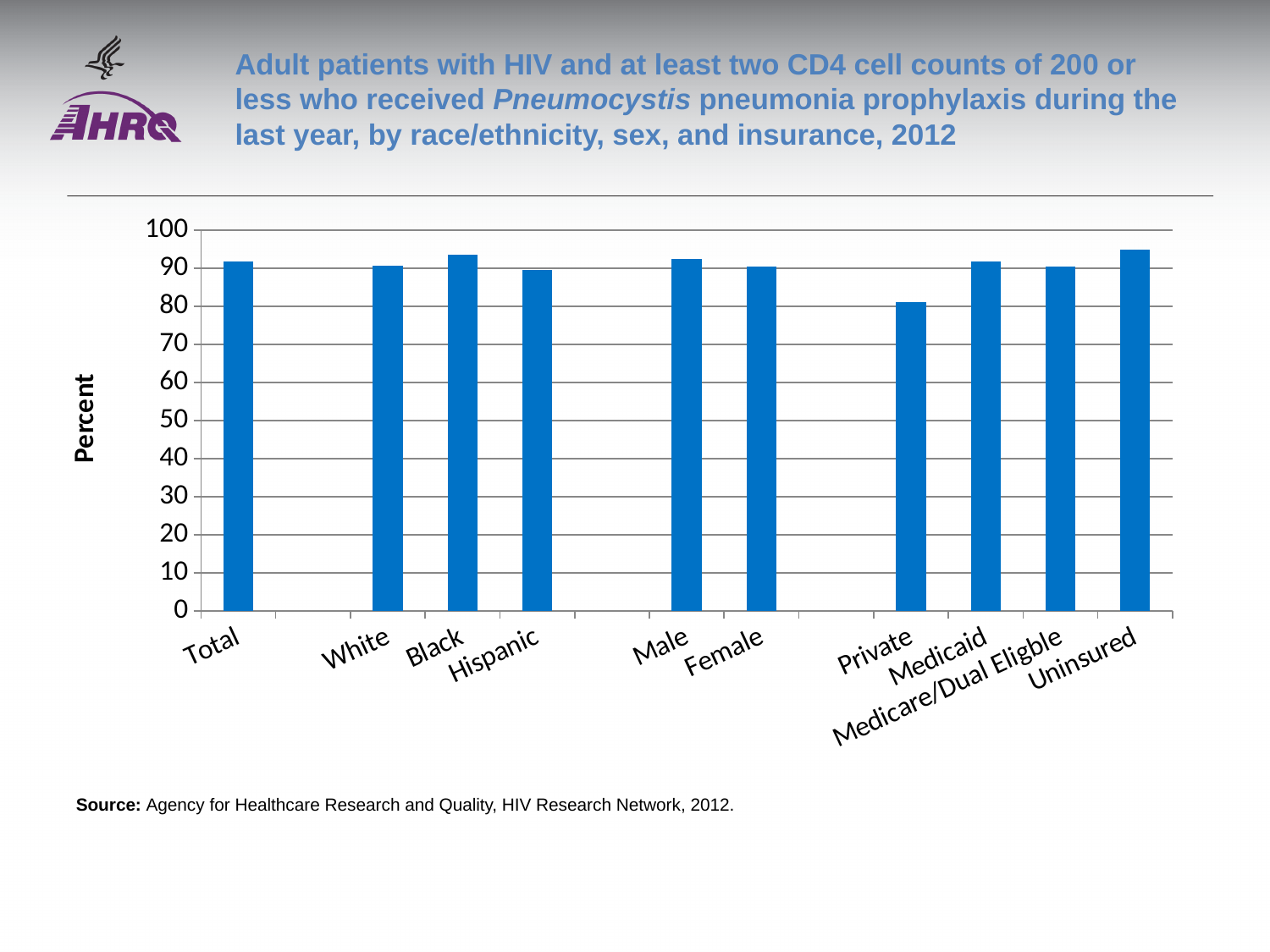
Which insurance category has the lowest value among Private, Medicaid, Medicare/Dual Eligible, and Uninsured? Private Is the value for Uninsured greater or less than 90? greater Which category has the highest value in the chart? Uninsured Which is larger, the value for Black or the value for Hispanic? Black What kind of chart is shown on the slide? bar chart Is the value for Black greater or less than 90? greater What is the label on the vertical axis of the chart? Percent How many bars (categories) are plotted in the chart? 10 Is the value for Private greater or less than 90? less Which category has the lowest value in the chart? Private Which is larger, the value for Private or the value for Uninsured? Uninsured